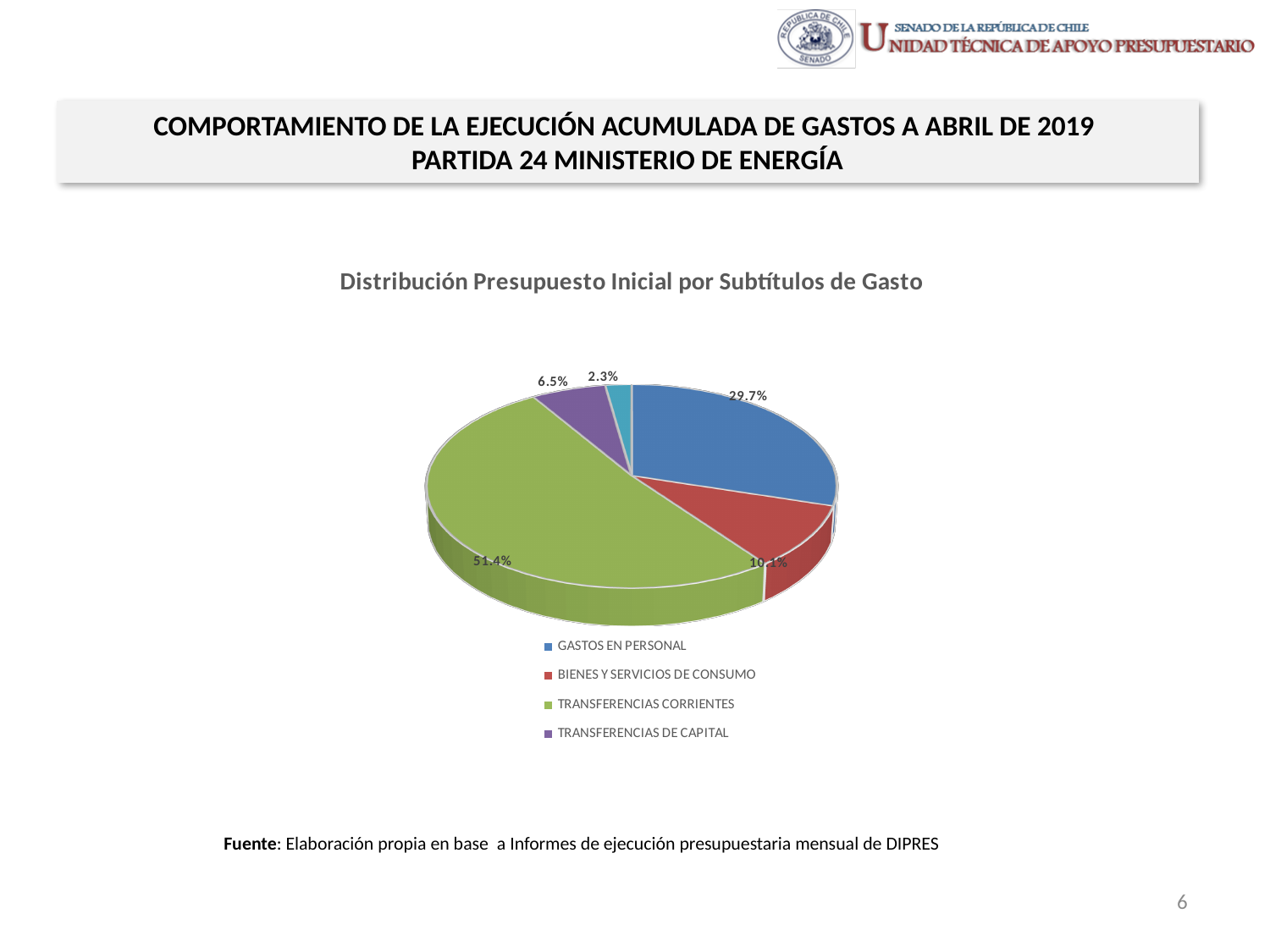
What share of the pie does GASTOS EN PERSONAL represent? 29.7% What is the title of the chart? Distribución Presupuesto Inicial por Subtítulos de Gasto Which of the categories listed in the legend has the smallest share of the pie? TRANSFERENCIAS DE CAPITAL What colour is the slice for TRANSFERENCIAS CORRIENTES? Green Which category has the largest share of the pie? TRANSFERENCIAS CORRIENTES What share of the pie does TRANSFERENCIAS CORRIENTES represent? 51.4% Which is larger, the share for GASTOS EN PERSONAL or the share for BIENES Y SERVICIOS DE CONSUMO? GASTOS EN PERSONAL How many entries does the chart legend list? 4 What share of the pie does BIENES Y SERVICIOS DE CONSUMO represent? 10.1% What share of the pie does TRANSFERENCIAS DE CAPITAL represent? 6.5% What is the difference in percentage points between TRANSFERENCIAS CORRIENTES and GASTOS EN PERSONAL? 21.7 What kind of chart is shown on the slide? Pie chart